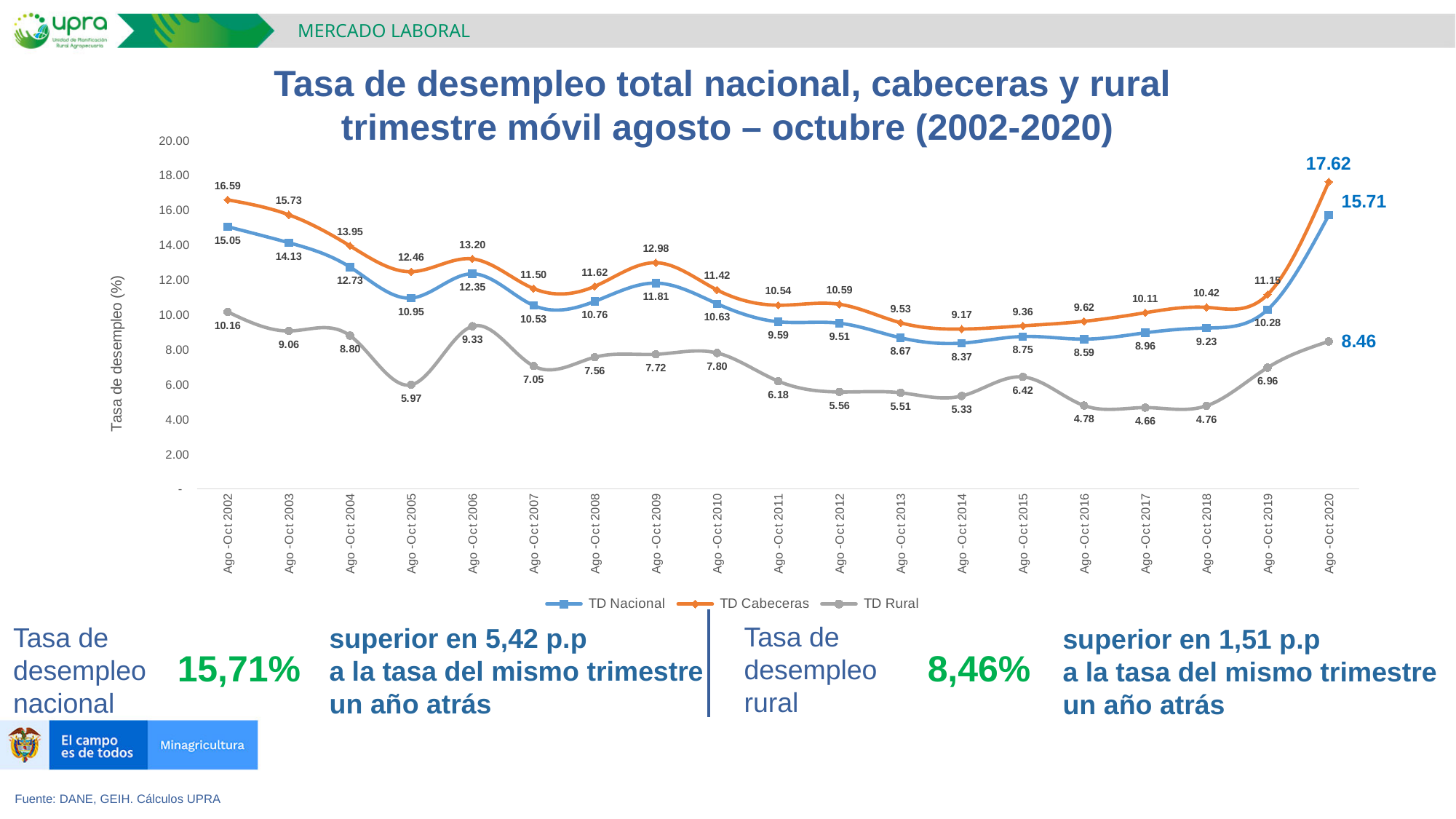
What is the value of TD Nacional for Ago-Oct 2014? 8.37 How many series does the legend list? 3 Which is larger for TD Nacional: the value in Ago-Oct 2006 or in Ago-Oct 2009? Ago-Oct 2006 What is the value of TD Rural for Ago-Oct 2005? 5.97 In which period is TD Rural at its lowest? Ago-Oct 2017 What is the value of TD Cabeceras for Ago-Oct 2020? 17.62 Does TD Nacional rise or fall from Ago-Oct 2002 to Ago-Oct 2005? fall What is the difference between TD Cabeceras and TD Nacional in Ago-Oct 2020? 1.91 In which period is TD Rural at its highest? Ago-Oct 2002 What kind of chart is shown on the slide? line chart How many time periods are plotted along the x axis? 19 Is the value of TD Rural for Ago-Oct 2014 greater or less than 6.00? less